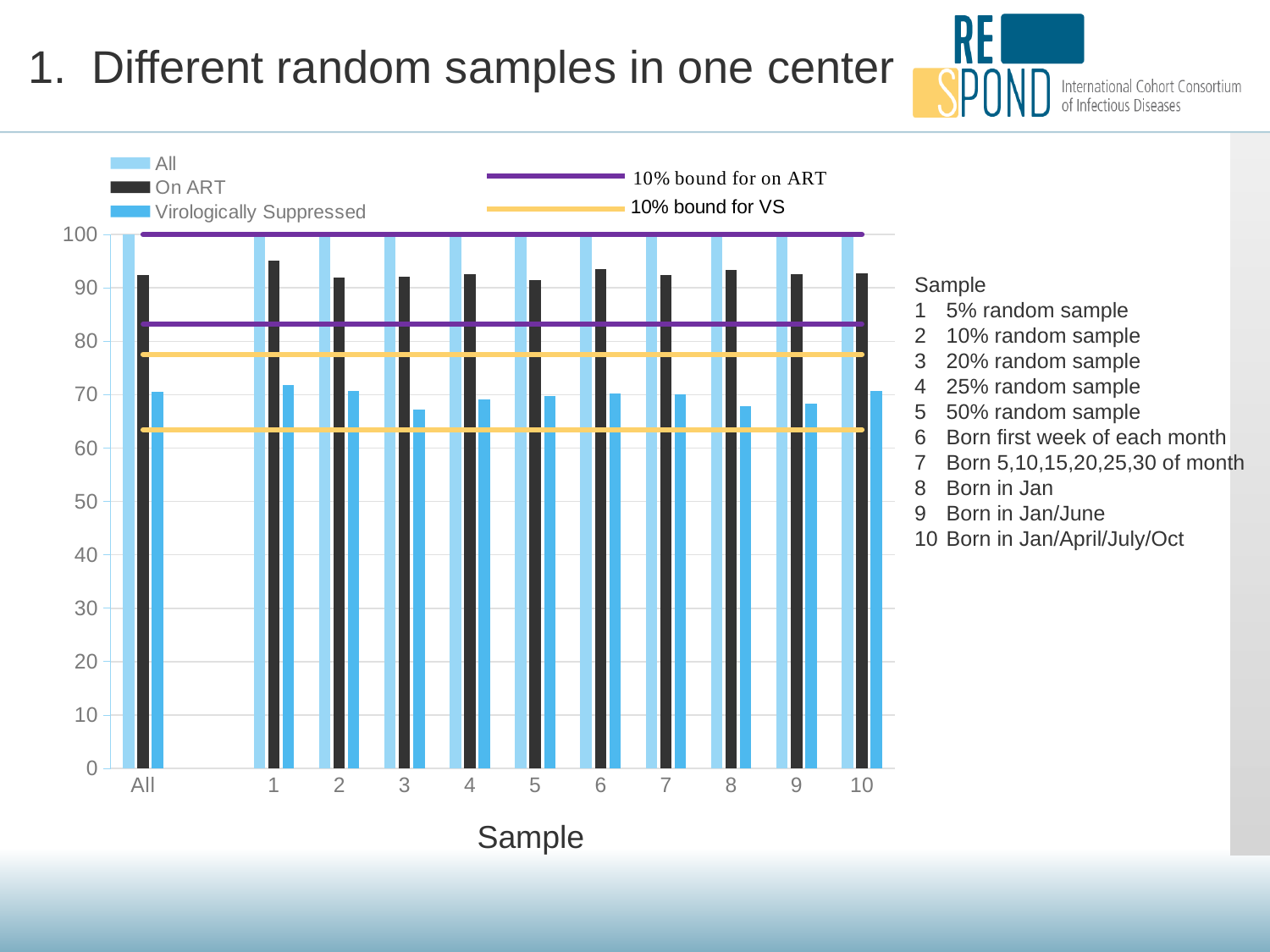
What is the title of the x axis of the chart? Sample Is the 'Virologically Suppressed' value for sample 1 greater or less than 70? greater Is the 'On ART' value for the 'All' category greater or less than 90? greater Is the 'Virologically Suppressed' value for sample 3 greater or less than 70? less Which is larger, the 'On ART' value for sample 1 or for sample 5? sample 1 What kind of chart is shown on the slide? bar chart How many categories are shown along the x axis of the chart? 11 Which is larger, the 'Virologically Suppressed' value for sample 1 or for sample 3? sample 1 What is the value of the 'All' series for each sample on the chart? 100 How many series does the chart's legend list in total, including the bound lines? 5 Which sample has the highest 'On ART' value? 1